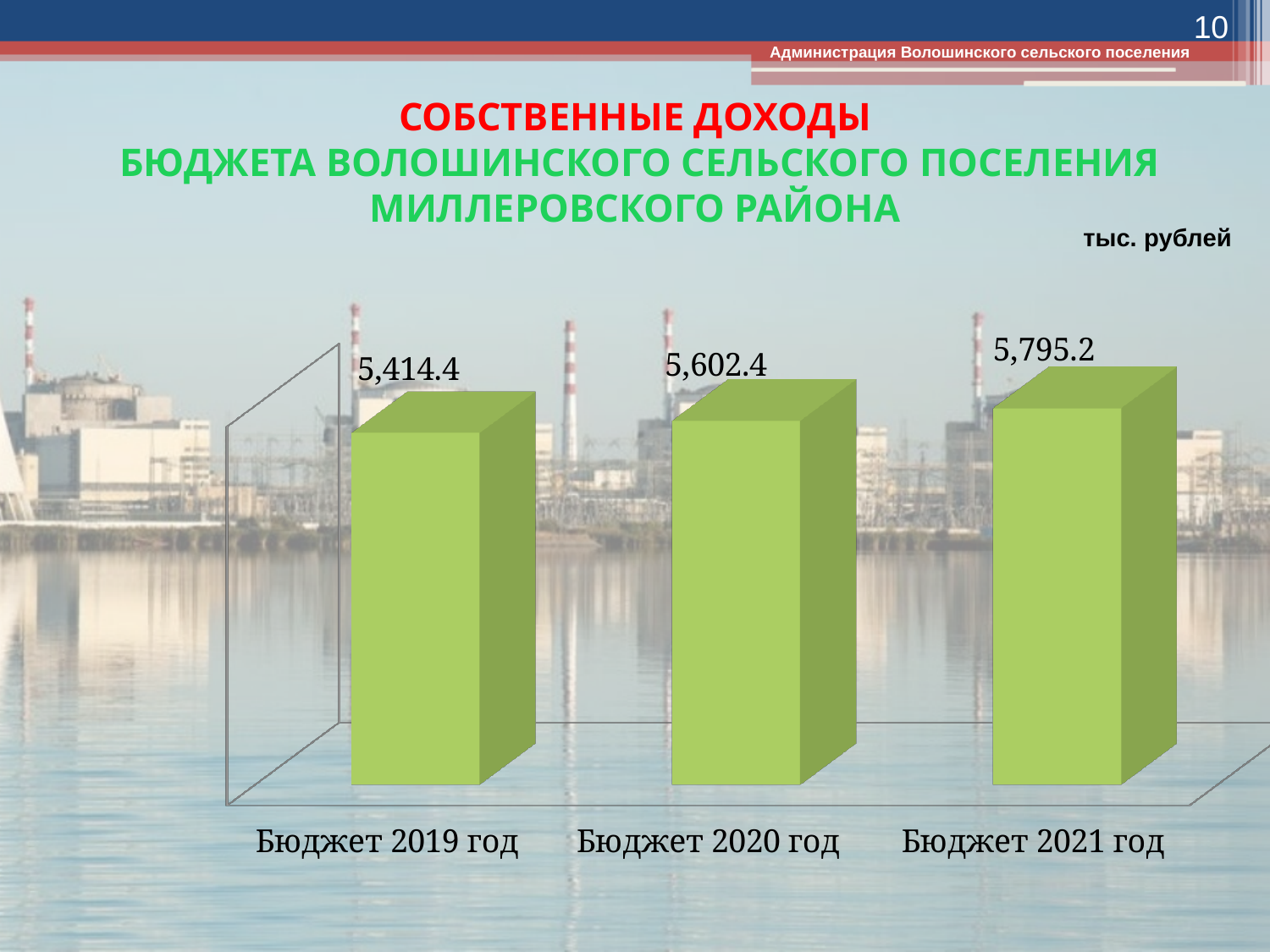
Do the values rise or fall from Бюджет 2019 год to Бюджет 2021 год? Rise Which category has the highest value? Бюджет 2021 год What is the value for Бюджет 2019 год? 5,414.4 What is the difference between the values for Бюджет 2021 год and Бюджет 2019 год? 380.8 What is the difference between the values for Бюджет 2021 год and Бюджет 2020 год? 192.8 How many categories are shown in the chart? 3 Which category has the lowest value? Бюджет 2019 год Which is larger, the value for Бюджет 2020 год or Бюджет 2021 год? Бюджет 2021 год What kind of chart is shown on the slide? Bar chart What is the difference between the values for Бюджет 2020 год and Бюджет 2019 год? 188.0 What is the value for Бюджет 2021 год? 5,795.2 What is the value for Бюджет 2020 год? 5,602.4